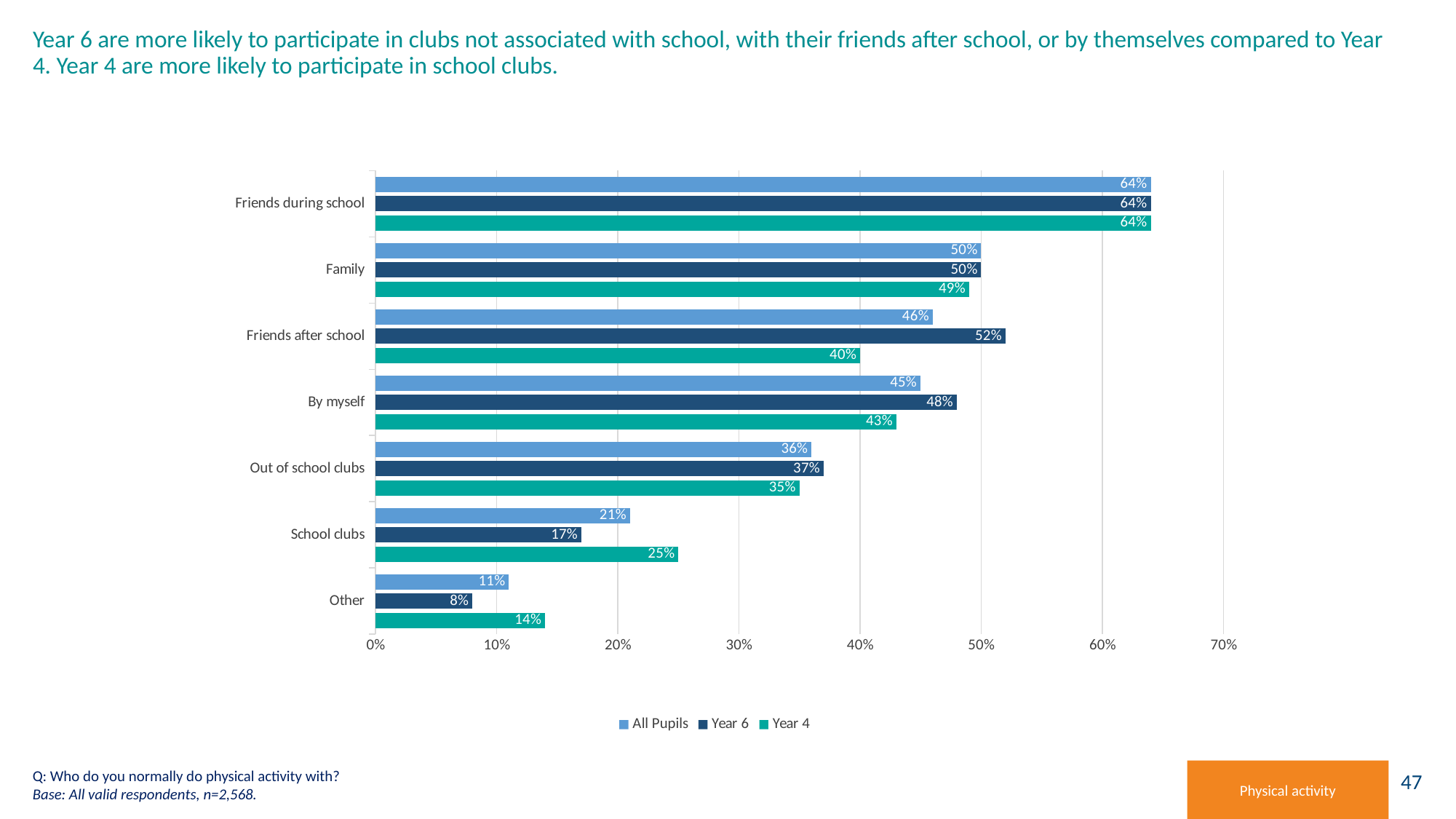
How many categories are shown on the chart? 7 Which is larger for School clubs: the Year 6 value or the Year 4 value? Year 4 What is the Year 6 value for Friends after school? 52% Which series is shown in dark blue in the legend? Year 6 What is the Year 4 value for School clubs? 25% Which category has the lowest Year 4 value? Other What is the All Pupils value for Out of school clubs? 36% What is the difference between the Year 6 and Year 4 values for Friends after school? 12% How many series does the legend list? 3 Which category has the highest Year 6 value? Friends during school Is the Year 6 value for By myself greater or less than 40%? greater What kind of chart is shown on the slide? bar chart